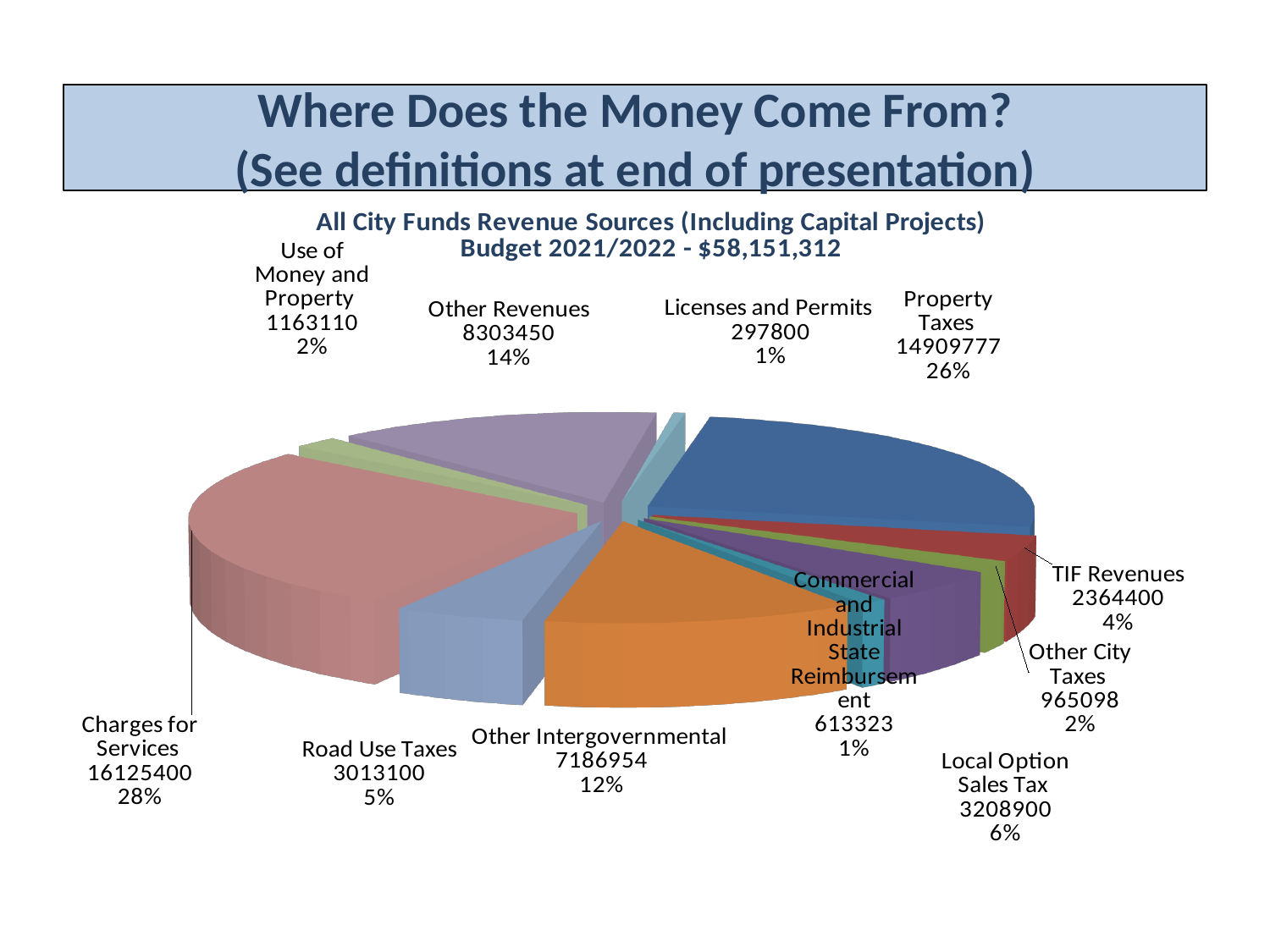
What is the value for Other Intergovernmental? 7186954 Which is larger, Local Option Sales Tax or Road Use Taxes? Local Option Sales Tax How many revenue sources are shown in the pie chart? 11 What is the value for TIF Revenues? 2364400 Which revenue source is the largest slice of the pie? Charges for Services What is the difference between Charges for Services and Property Taxes? 1215623 What share of the pie does Property Taxes represent? 26% What share of the pie does Other Revenues represent? 14% What is the value for Property Taxes? 14909777 Which revenue source has the smallest value? Licenses and Permits What type of chart is shown on the slide? Pie chart What is the value for Road Use Taxes? 3013100